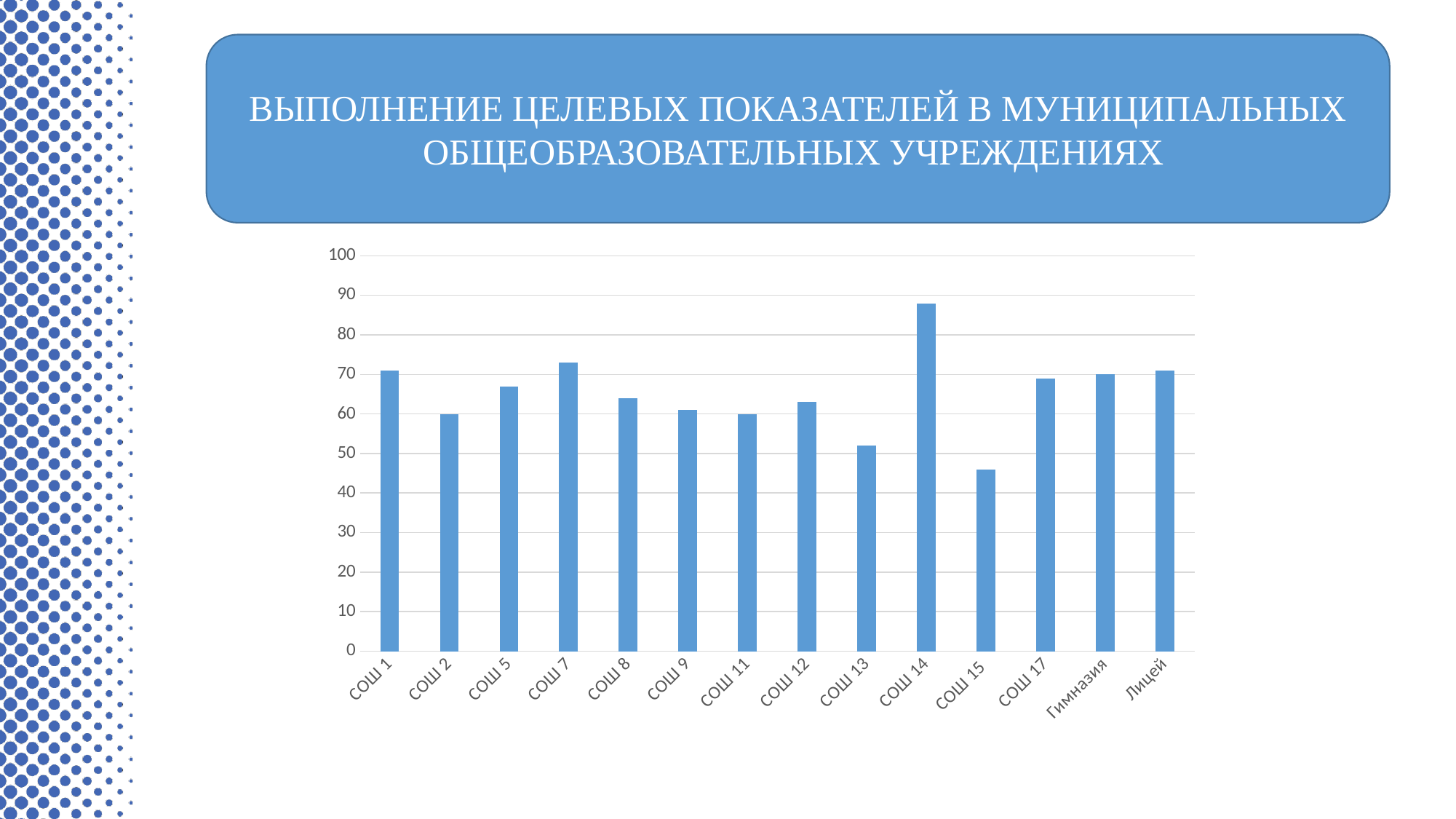
Which is larger, the value for СОШ 7 or the value for СОШ 13? СОШ 7 Is the value for СОШ 13 greater or less than 60? less Is the value for СОШ 15 greater or less than 50? less Is the value for СОШ 14 greater or less than 80? greater Which institution has the lowest bar? СОШ 15 What is the maximum value shown on the vertical axis? 100 What is the title shown above the chart? ВЫПОЛНЕНИЕ ЦЕЛЕВЫХ ПОКАЗАТЕЛЕЙ В МУНИЦИПАЛЬНЫХ ОБЩЕОБРАЗОВАТЕЛЬНЫХ УЧРЕЖДЕНИЯХ Which institution has the highest bar? СОШ 14 How many institutions (categories) are plotted on the x axis? 14 Which is larger, the value for СОШ 15 or the value for Лицей? Лицей What kind of chart is shown on the slide? bar chart